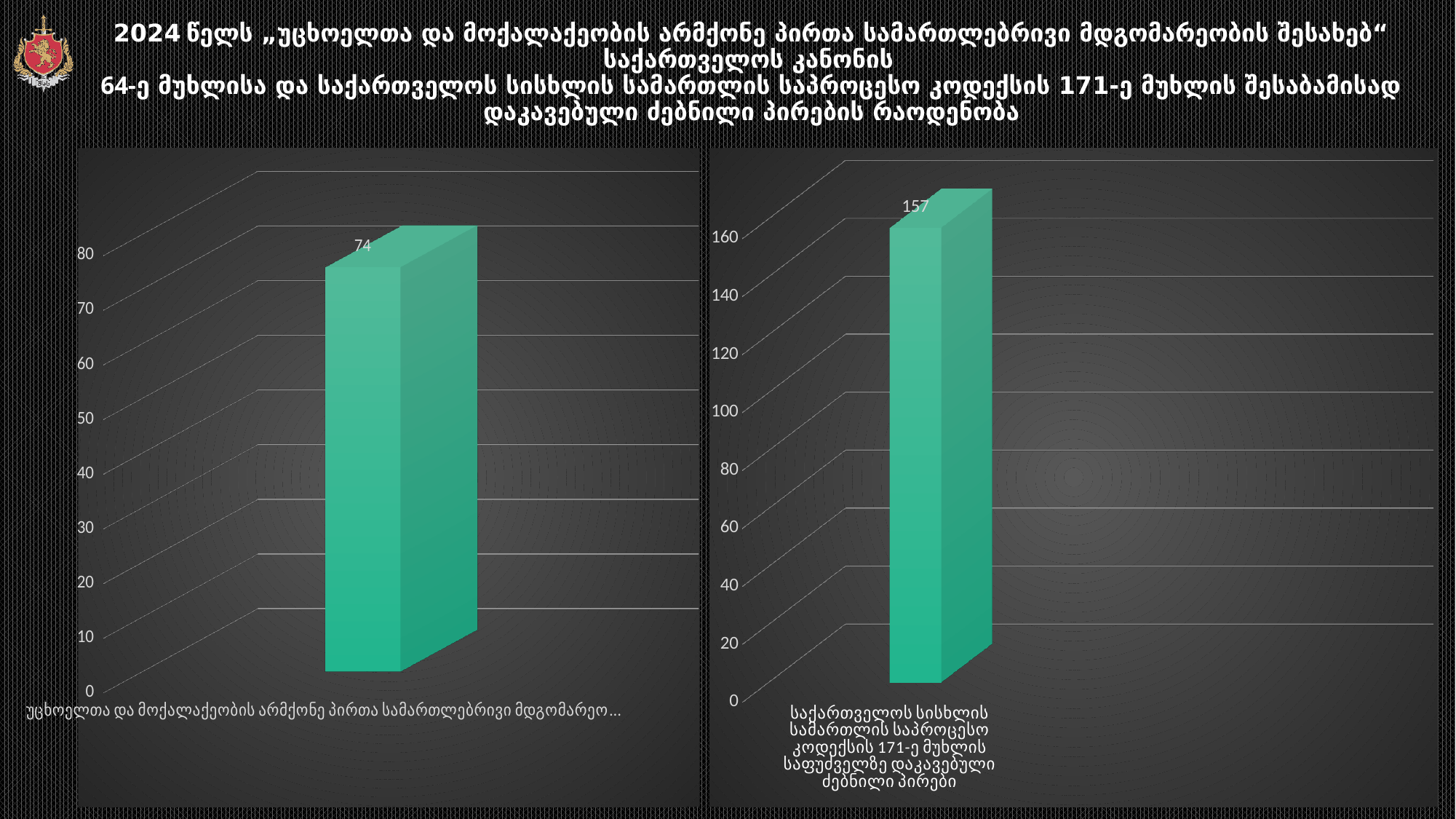
On the right chart, what is the value shown on the bar? 157 What kind of chart is the right chart? bar chart How many bars are plotted on the right chart? 1 Which is larger: the bar value on the left chart or the bar value on the right chart? the right chart (157) On the left chart, is the value of the bar greater or less than 70? greater What kind of chart is the left chart? bar chart What is the highest tick label on the vertical axis of the left chart? 80 How many bars are plotted on the left chart? 1 On the right chart, is the value of the bar greater or less than 140? greater What is the difference between the bar value on the right chart (157) and the bar value on the left chart (74)? 83 What is the highest tick label on the vertical axis of the right chart? 160 On the left chart, what is the value shown on the bar? 74